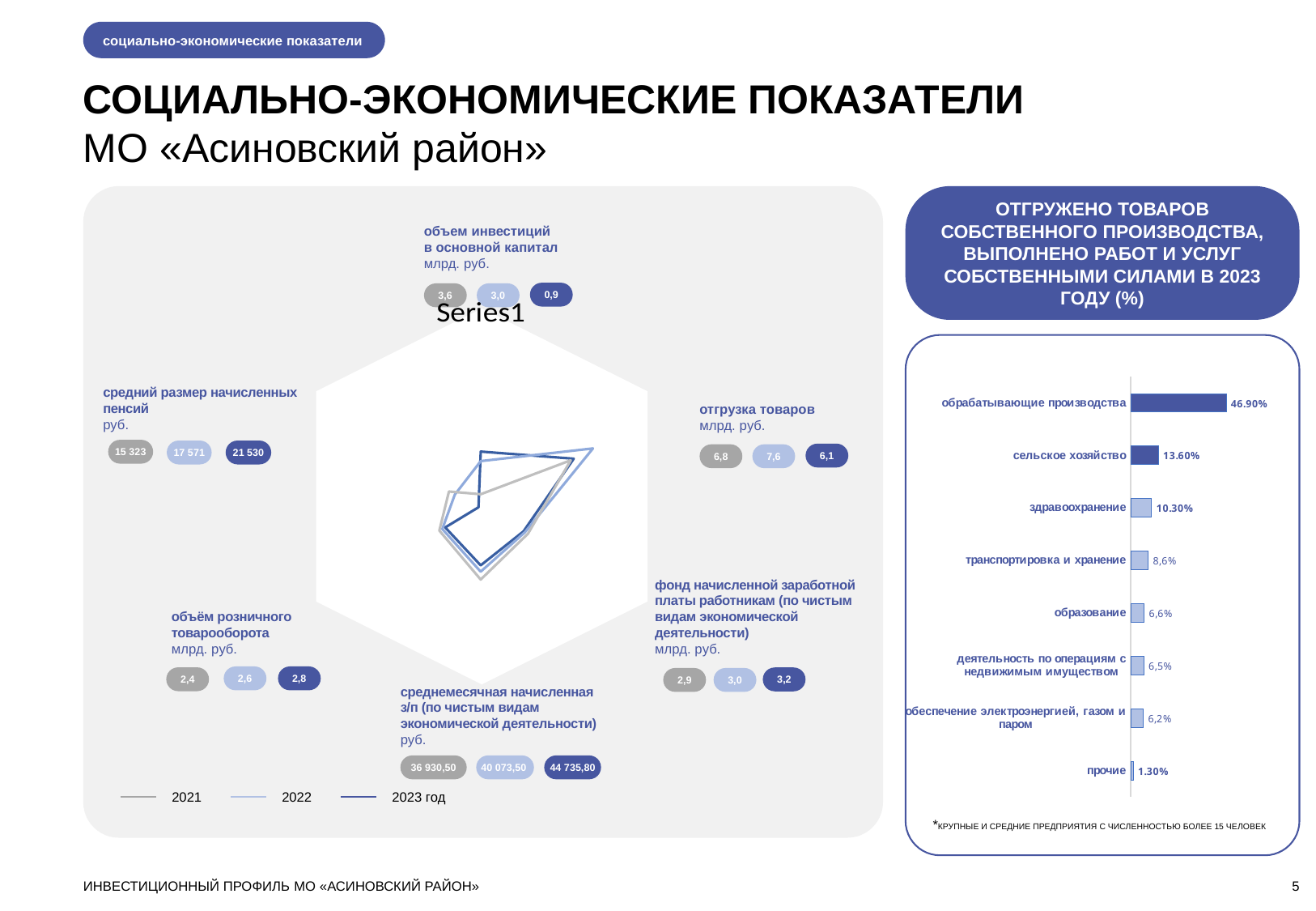
On the right-hand chart, which category has the highest value? обрабатывающие производства How many categories are shown on the right-hand bar chart? 8 How many series does the legend of the left-hand radar chart list? 3 On the right-hand chart, what is the value for транспортировка и хранение? 8,6% On the right-hand chart, what is the difference between обрабатывающие производства and сельское хозяйство? 33.30% On the right-hand chart (ОТГРУЖЕНО ТОВАРОВ СОБСТВЕННОГО ПРОИЗВОДСТВА...), what is the value for обрабатывающие производства? 46.90% On the right-hand chart, what is the value for сельское хозяйство? 13.60% On the left-hand radar chart, what is the 2023 value for отгрузка товаров (млрд. руб.)? 6,1 On the right-hand chart, which category has the lowest value? прочие On the right-hand chart, which is larger: здравоохранение or образование? здравоохранение What kind of chart is the right-hand chart? bar chart What kind of chart is the left-hand chart inside the hexagon? radar chart